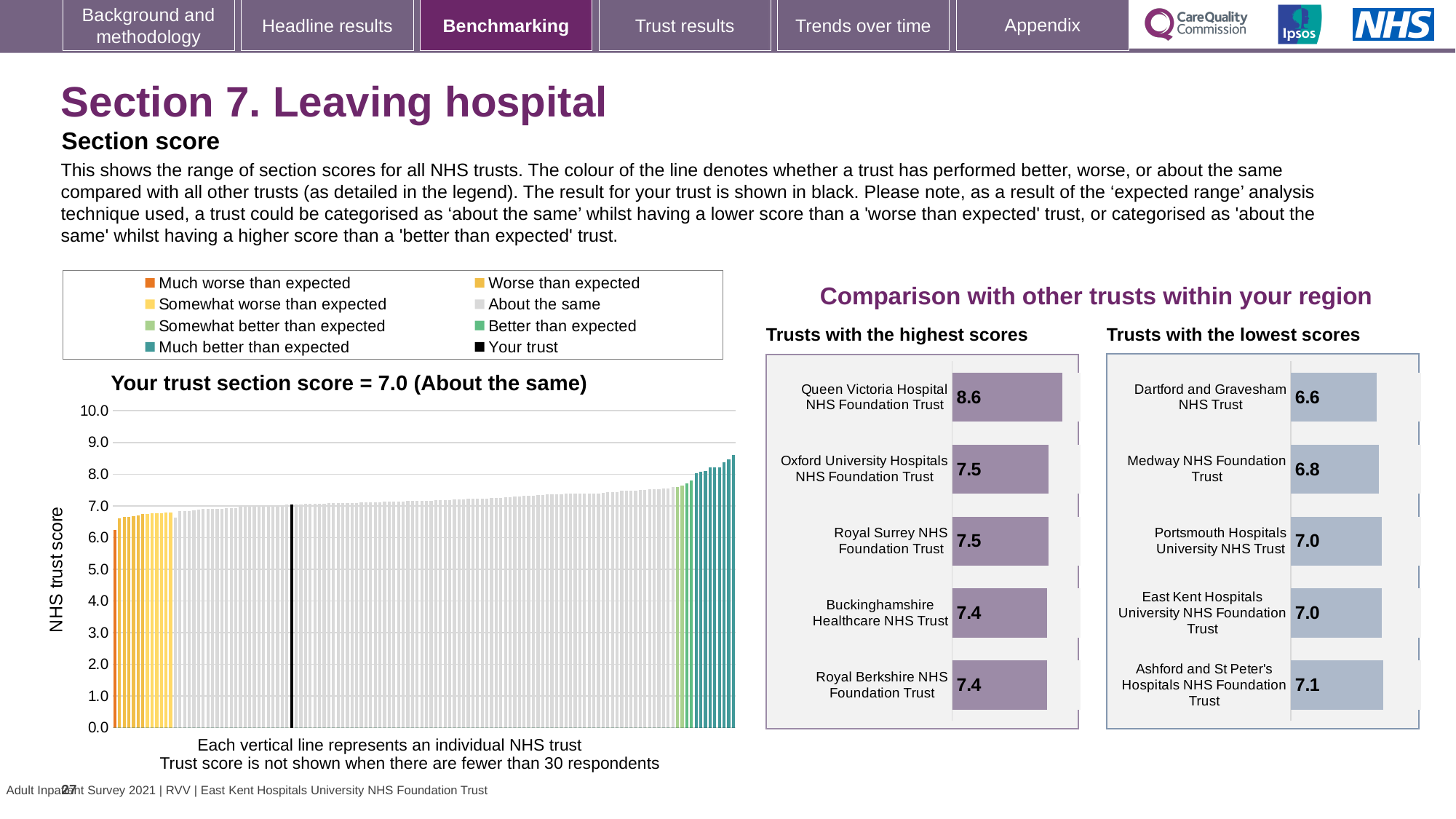
In the 'Trusts with the lowest scores' chart, what is the score for Dartford and Gravesham NHS Trust? 6.6 In the 'Trusts with the highest scores' chart, what is the score for Queen Victoria Hospital NHS Foundation Trust? 8.6 In the 'Your trust section score' chart on the left, do the values rise or fall from left to right along the x axis? Rise In the 'Trusts with the lowest scores' chart, what is the difference between the scores of Ashford and St Peter's Hospitals NHS Foundation Trust and Dartford and Gravesham NHS Trust? 0.5 What kind of chart is the 'Your trust section score' chart on the left of the slide? Bar chart In the 'Trusts with the highest scores' chart, which trust has the highest score? Queen Victoria Hospital NHS Foundation Trust In the 'Trusts with the lowest scores' chart, which trust has the lowest score? Dartford and Gravesham NHS Trust In the 'Trusts with the highest scores' chart, what is the difference between the scores of Queen Victoria Hospital NHS Foundation Trust and Oxford University Hospitals NHS Foundation Trust? 1.1 In the 'Trusts with the lowest scores' chart, which has the higher score: Medway NHS Foundation Trust or Portsmouth Hospitals University NHS Trust? Portsmouth Hospitals University NHS Trust How many trusts are shown in the 'Trusts with the highest scores' chart? 5 How many entries does the legend above the 'Your trust section score' chart list? 8 According to the chart title on the left, what is your trust's section score? 7.0